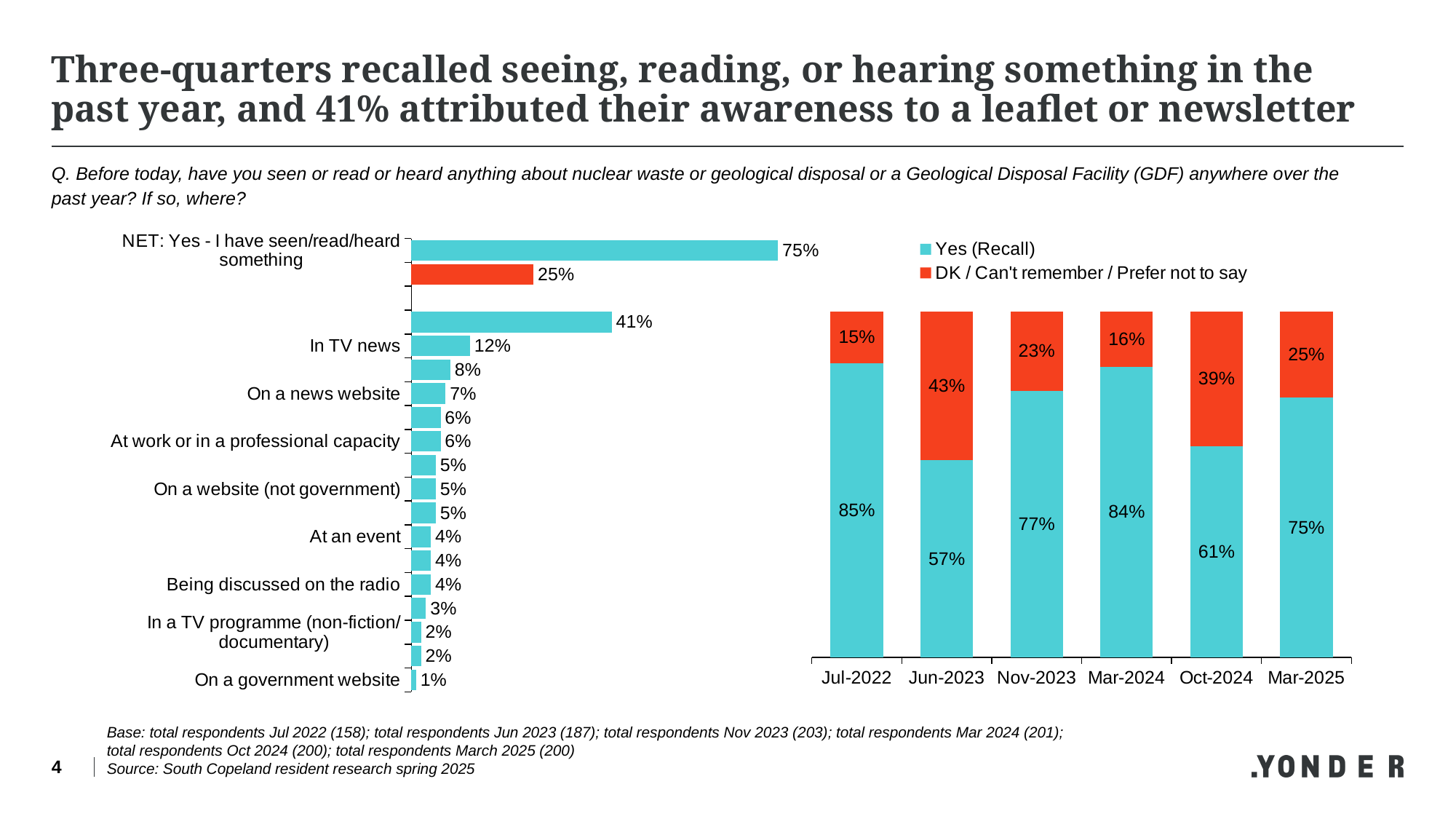
In the stacked bar chart on the right, how many time points are shown on the x axis? 6 In the stacked bar chart on the right, what is the difference between the Yes (Recall) values for Mar-2024 and Mar-2025? 9% In the stacked bar chart on the right, what is the DK / Can't remember / Prefer not to say value for Oct-2024? 39% What kind of chart is shown on the right of the slide? Stacked bar chart In the stacked bar chart on the right, what is the Yes (Recall) value for Jul-2022? 85% In the stacked bar chart on the right, what is the total of the Jun-2023 bar? 100% In the stacked bar chart on the right, how many series does the legend list? 2 In the horizontal bar chart on the left, which is larger: the value for 'On a news website' or the value for 'At an event'? On a news website In the stacked bar chart on the right, which time point has the highest Yes (Recall) value? Jul-2022 In the horizontal bar chart on the left, what is the value for 'In TV news'? 12% In the stacked bar chart on the right, which time point has the lowest Yes (Recall) value? Jun-2023 In the horizontal bar chart on the left, what is the value for 'On a government website'? 1%